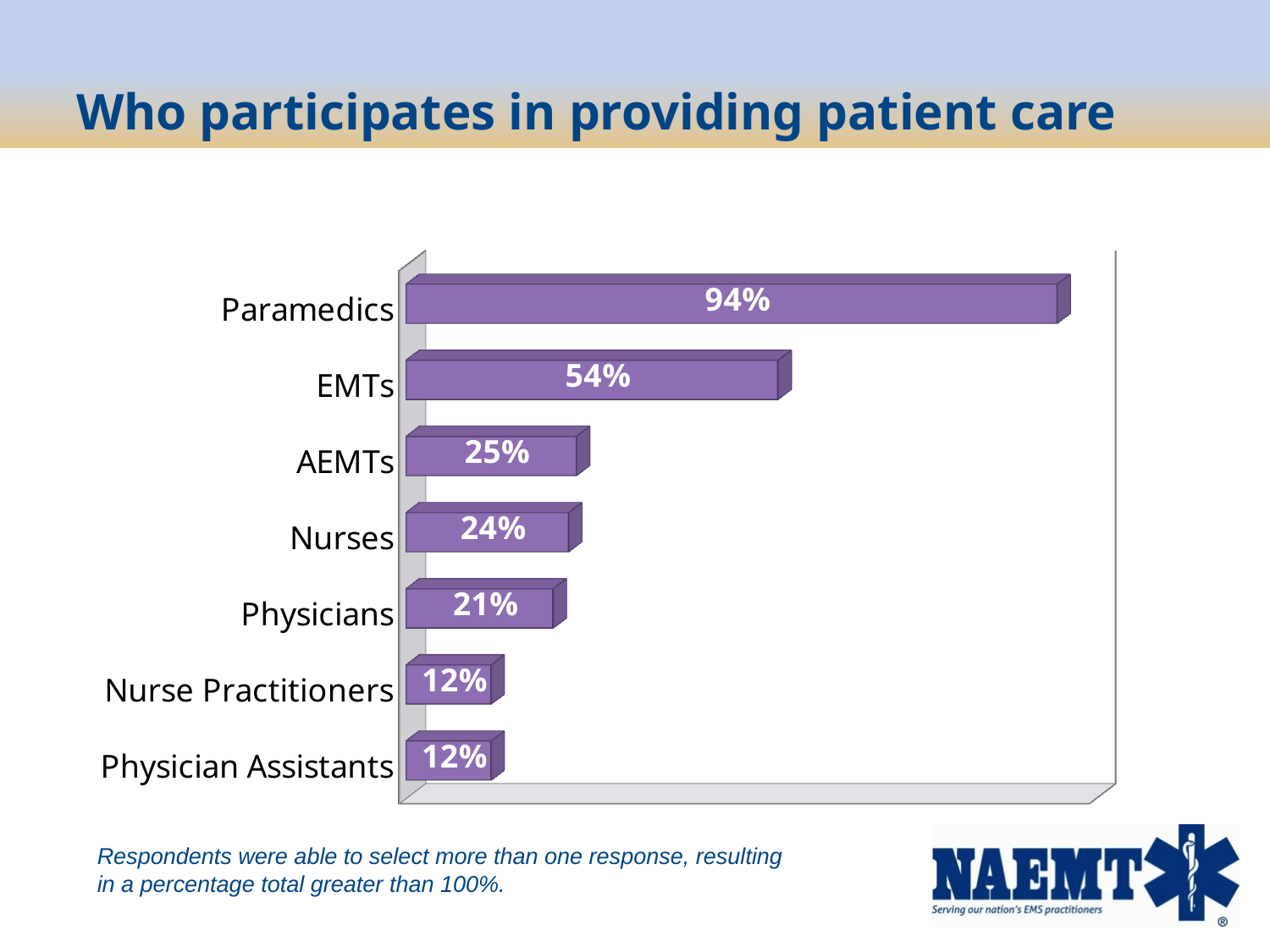
What is the difference between the values for Paramedics and EMTs? 40% What percentage is shown for Paramedics? 94% What percentage is shown for Physicians? 21% What percentage is shown for EMTs? 54% What percentage is shown for Nurses? 24% What kind of chart is shown on the slide? Bar chart How many categories are shown in the chart? 7 What colour are the bars in the chart? Purple Which category has the highest value? Paramedics What is the difference between the values for AEMTs and Physicians? 4% What is the title of the slide? Who participates in providing patient care Which is larger, the value for EMTs or the value for AEMTs? EMTs